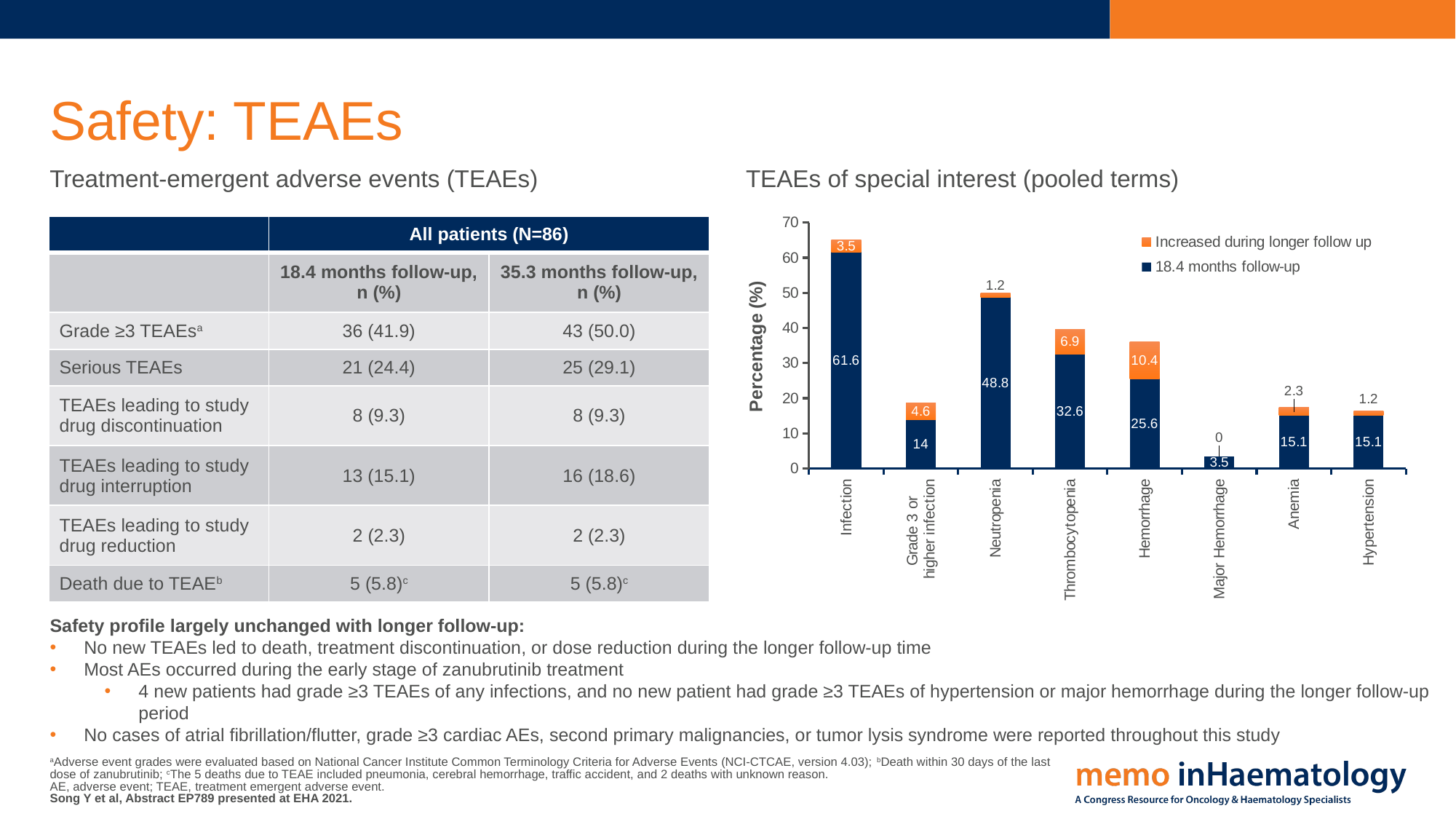
Which category has the highest 18.4 months follow-up value? Infection What is the 18.4 months follow-up value for Infection? 61.6 What is the 'Increased during longer follow up' value for Hemorrhage? 10.4 Which is larger, the 'Increased during longer follow up' value for Thrombocytopenia or for Anemia? Thrombocytopenia Which category has the lowest 18.4 months follow-up value? Major Hemorrhage What is the 18.4 months follow-up value for Thrombocytopenia? 32.6 What is the total stacked value for Hemorrhage? 36 How many categories are shown on the x axis? 8 What is the label of the y axis? Percentage (%) What kind of chart is shown? Stacked bar chart How many series does the legend list? 2 What is the difference between the 18.4 months follow-up values for Neutropenia and Thrombocytopenia? 16.2